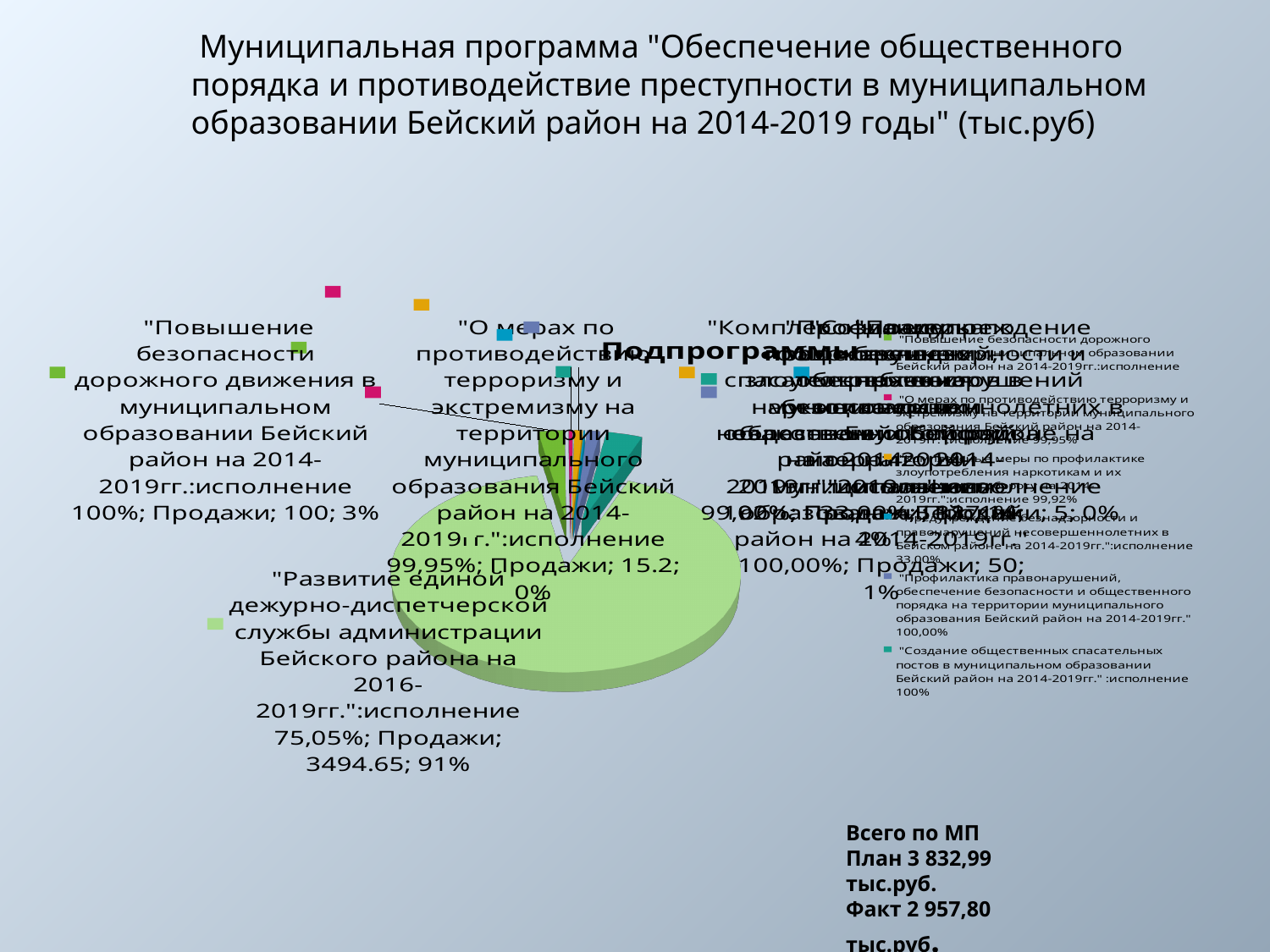
Which is larger: the value for "Повышение безопасности дорожного движения" or the value for "О мерах по противодействию терроризму и экстремизму"? "Повышение безопасности дорожного движения" What is the difference between the value for "Повышение безопасности дорожного движения" (100) and the value for "О мерах по противодействию терроризму и экстремизму" (15.2)? 84.8 What is the value shown for the slice "Повышение безопасности дорожного движения в муниципальном образовании Бейский район на 2014-2019гг."? 100 What kind of chart is shown on the slide? pie chart What is the value shown for the slice "О мерах по противодействию терроризму и экстремизму на территории муниципального образования Бейский район на 2014-2019гг."? 15.2 What is the value shown for the slice "Развитие единой дежурно-диспетчерской службы администрации Бейского района на 2016-2019гг."? 3494.65 What execution percentage is shown in the label for "Развитие единой дежурно-диспетчерской службы администрации Бейского района на 2016-2019гг."? 75,05% What share of the pie does the slice for "Повышение безопасности дорожного движения в муниципальном образовании Бейский район на 2014-2019гг." represent? 3% What share of the pie does the slice for "О мерах по противодействию терроризму и экстремизму на территории муниципального образования Бейский район на 2014-2019гг." represent? 0% What share of the pie does the slice for "Развитие единой дежурно-диспетчерской службы администрации Бейского района на 2016-2019гг." represent? 91% Which slice of the pie is the largest? "Развитие единой дежурно-диспетчерской службы администрации Бейского района на 2016-2019гг."